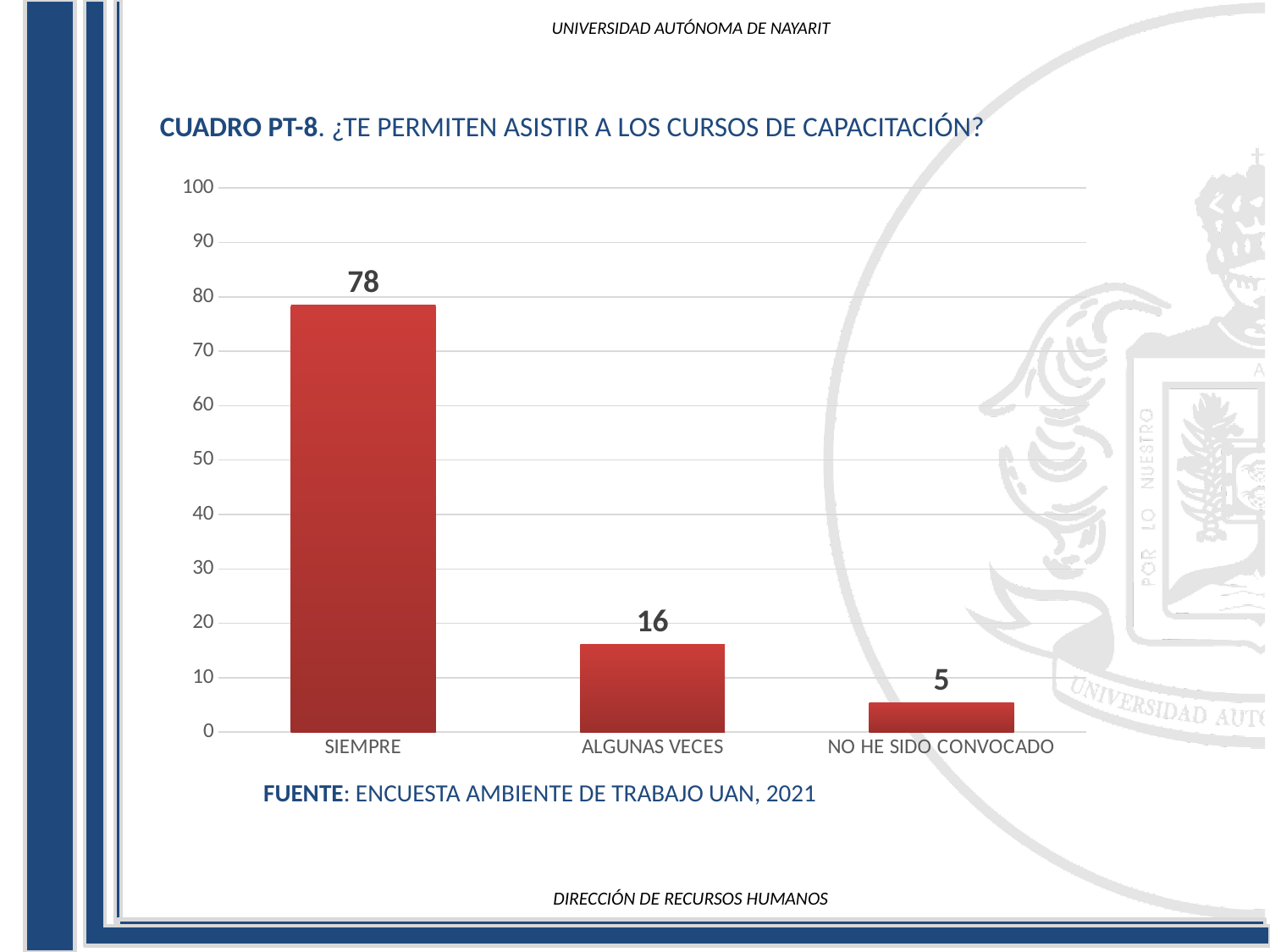
What is the difference between the values for ALGUNAS VECES and NO HE SIDO CONVOCADO? 11 Is the value for SIEMPRE greater or less than 70? greater Which category has the highest value? SIEMPRE Which category has the lowest value? NO HE SIDO CONVOCADO Which is larger, the value for ALGUNAS VECES or the value for NO HE SIDO CONVOCADO? ALGUNAS VECES What kind of chart is shown on the slide? bar chart What is the value for ALGUNAS VECES? 16 What is the value for SIEMPRE? 78 Do the values rise or fall from left to right along the x axis? fall What is the difference between the values for SIEMPRE and ALGUNAS VECES? 62 How many categories are shown on the x axis? 3 What is the value for NO HE SIDO CONVOCADO? 5